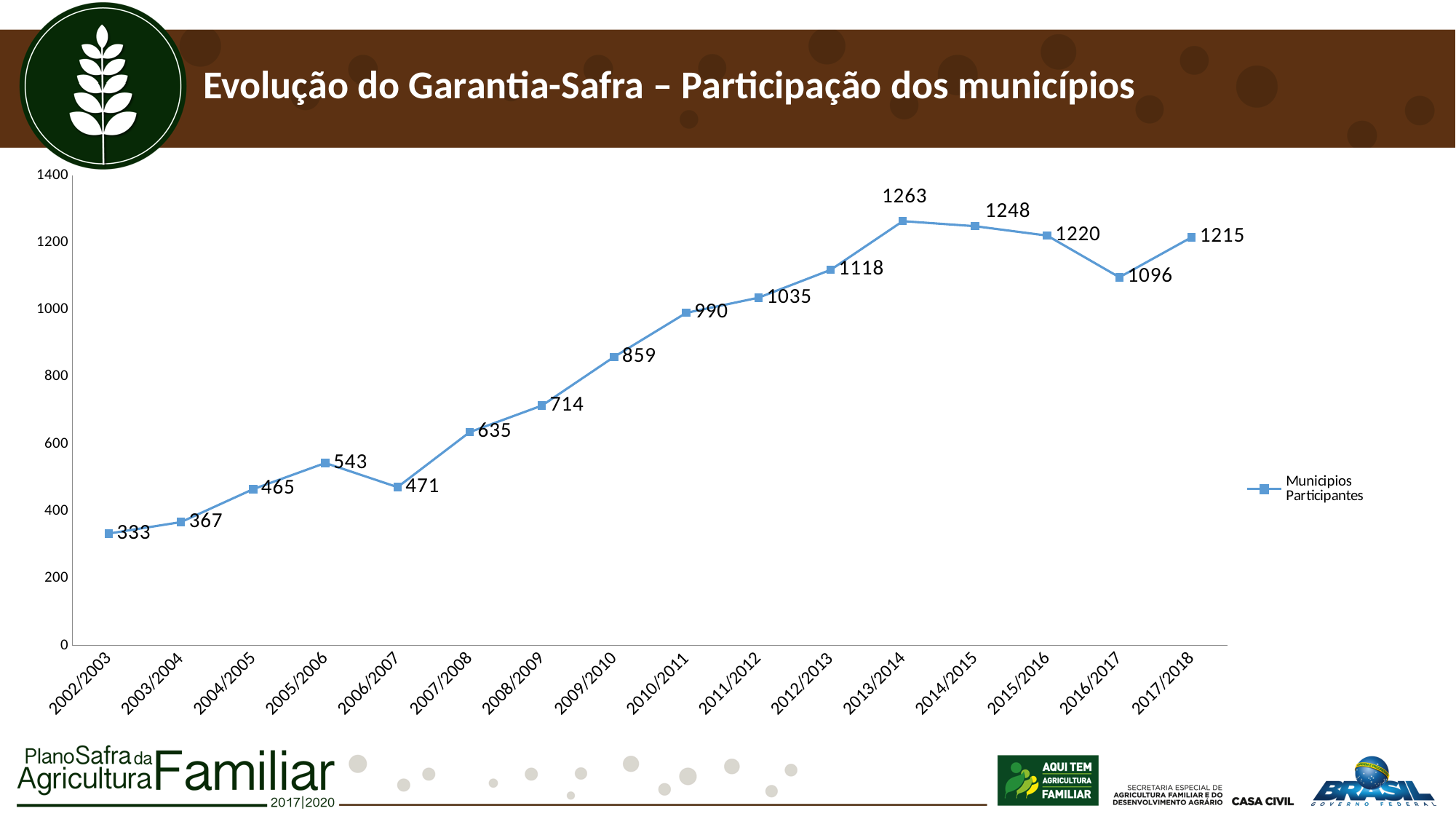
What is the difference between the values for 2017/2018 and 2016/2017? 119 How many data points are plotted on the chart? 16 Which year has the highest number of participating municipalities? 2013/2014 What is the value for 2016/2017? 1096 Which is larger, the value for 2005/2006 or the value for 2006/2007? 2005/2006 What is the difference between the values for 2013/2014 and 2002/2003? 930 What kind of chart is shown on the slide? Line chart What is the name of the series shown in the legend? Municipios Participantes How many series does the legend list? 1 Which year has the lowest number of participating municipalities? 2002/2003 What is the value for 2002/2003? 333 What is the value for 2013/2014? 1263